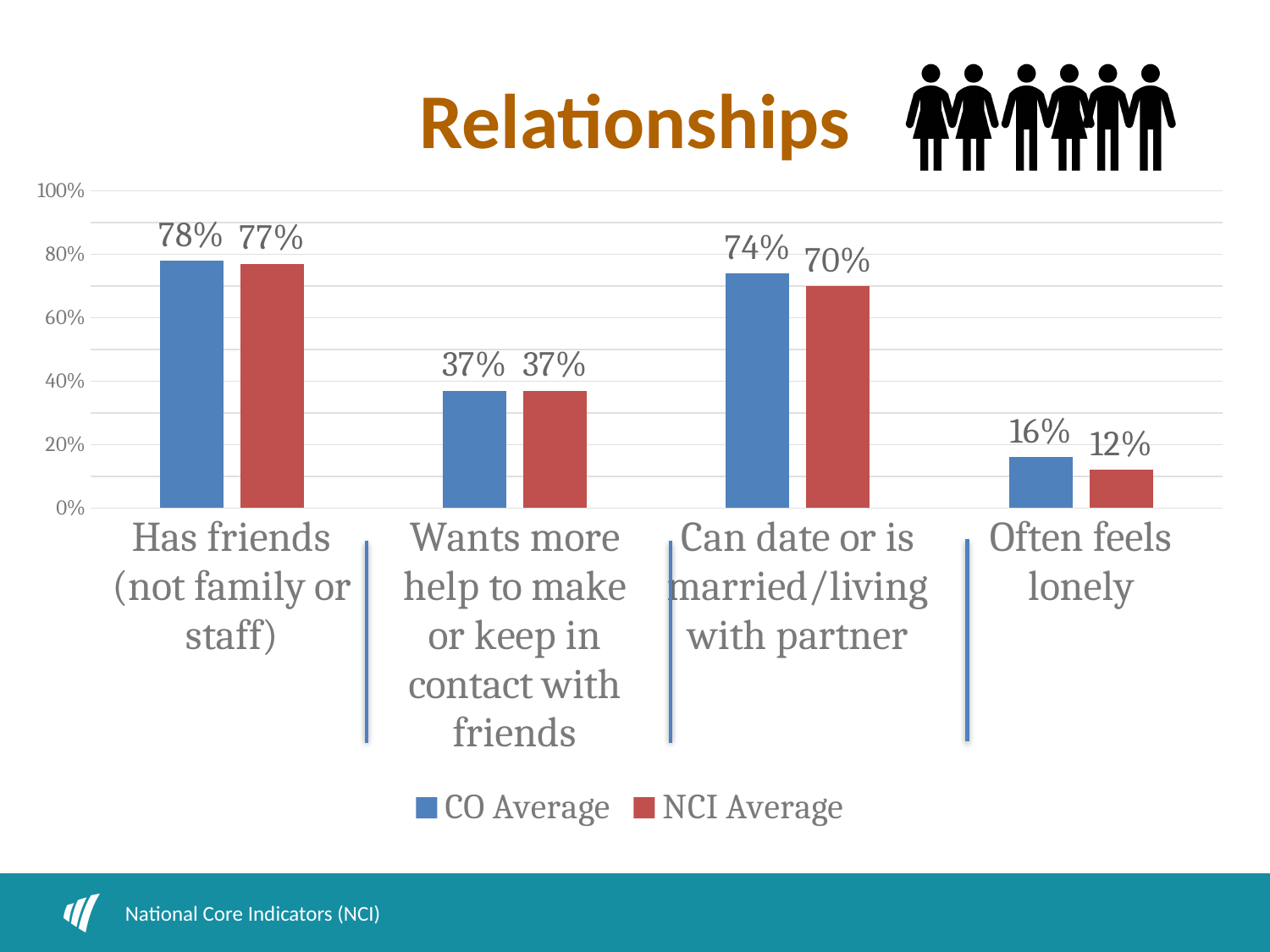
What is the NCI Average value for "Can date or is married/living with partner"? 70% Which category has the highest CO Average value? Has friends (not family or staff) How many series does the legend list? 2 What is the title of the chart? Relationships What is the CO Average value for "Has friends (not family or staff)"? 78% Is the CO Average value for "Wants more help to make or keep in contact with friends" greater or less than 40%? less For "Often feels lonely", which is larger: the CO Average or the NCI Average? CO Average How many categories are shown on the x axis? 4 What kind of chart is shown on the slide? Bar chart What is the NCI Average value for "Often feels lonely"? 12% What is the difference between the CO Average and NCI Average for "Can date or is married/living with partner"? 4% Which category has the lowest NCI Average value? Often feels lonely